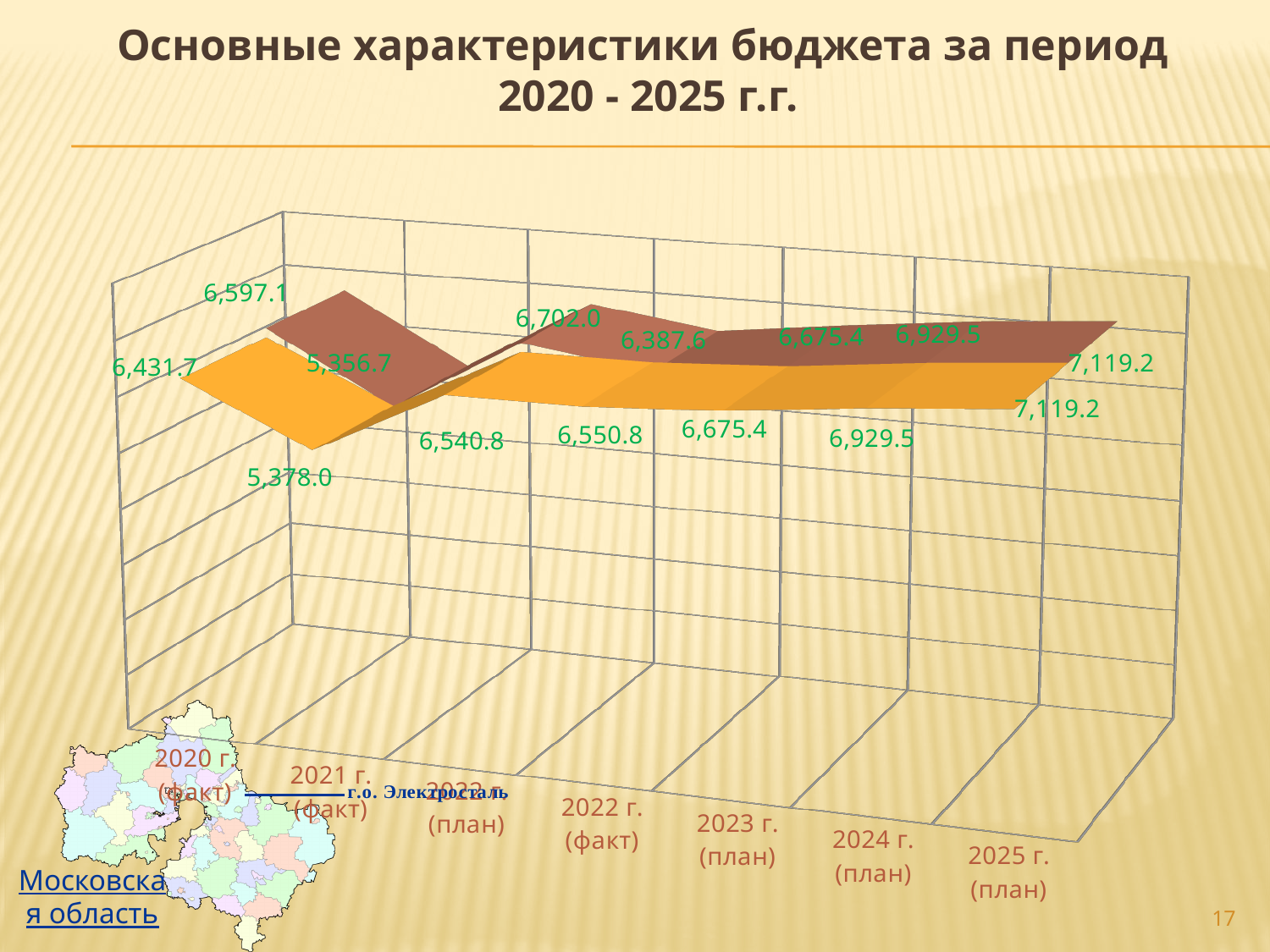
In which category does the brown (back) series have its highest value? 2025 г. (план) How many categories are shown along the x axis of the chart? 7 How many data series are plotted in the chart? 2 What is the value of the orange (front) series for 2023 г. (план)? 6,675.4 What is the value of the brown (back) series for 2025 г. (план)? 7,119.2 What kind of chart is shown on the slide? 3D line chart In which category does the orange (front) series have its lowest value? 2021 г. (факт) What is the value of the brown (back) series for 2021 г. (факт)? 5,356.7 What is the title of the chart slide? Основные характеристики бюджета за период 2020 - 2025 г.г. What is the difference between the orange (front) series values for 2025 г. (план) and 2024 г. (план)? 189.7 For the brown (back) series, which is larger: the value for 2022 г. (план) or for 2022 г. (факт)? 2022 г. (план) What is the value of the orange (front) series for 2020 г. (факт)? 6,431.7